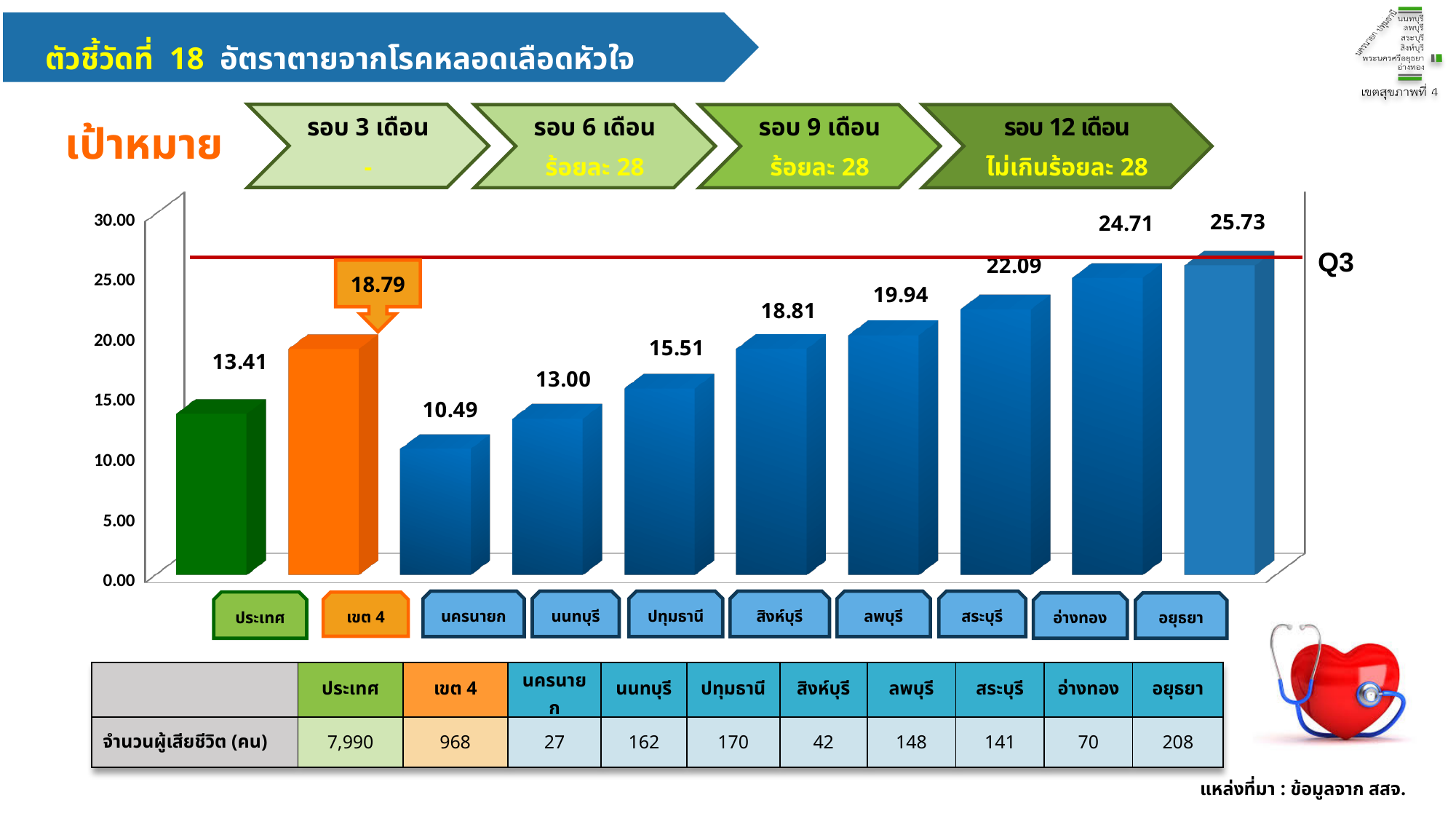
What is the difference between the values for อยุธยา and อ่างทอง? 1.02 Which is larger, the value for ลพบุรี or the value for ปทุมธานี? ลพบุรี What is the difference between the values for เขต 4 and ประเทศ? 5.38 Is the value for สระบุรี greater or less than 20.00? greater What kind of chart is shown on the slide? bar chart What is the value for เขต 4? 18.79 Which category has the lowest value? นครนายก What is the value for นครนายก? 10.49 What is the value for อยุธยา? 25.73 How many categories are shown on the x axis? 10 What is the value for สิงห์บุรี? 18.81 Which category has the highest value? อยุธยา